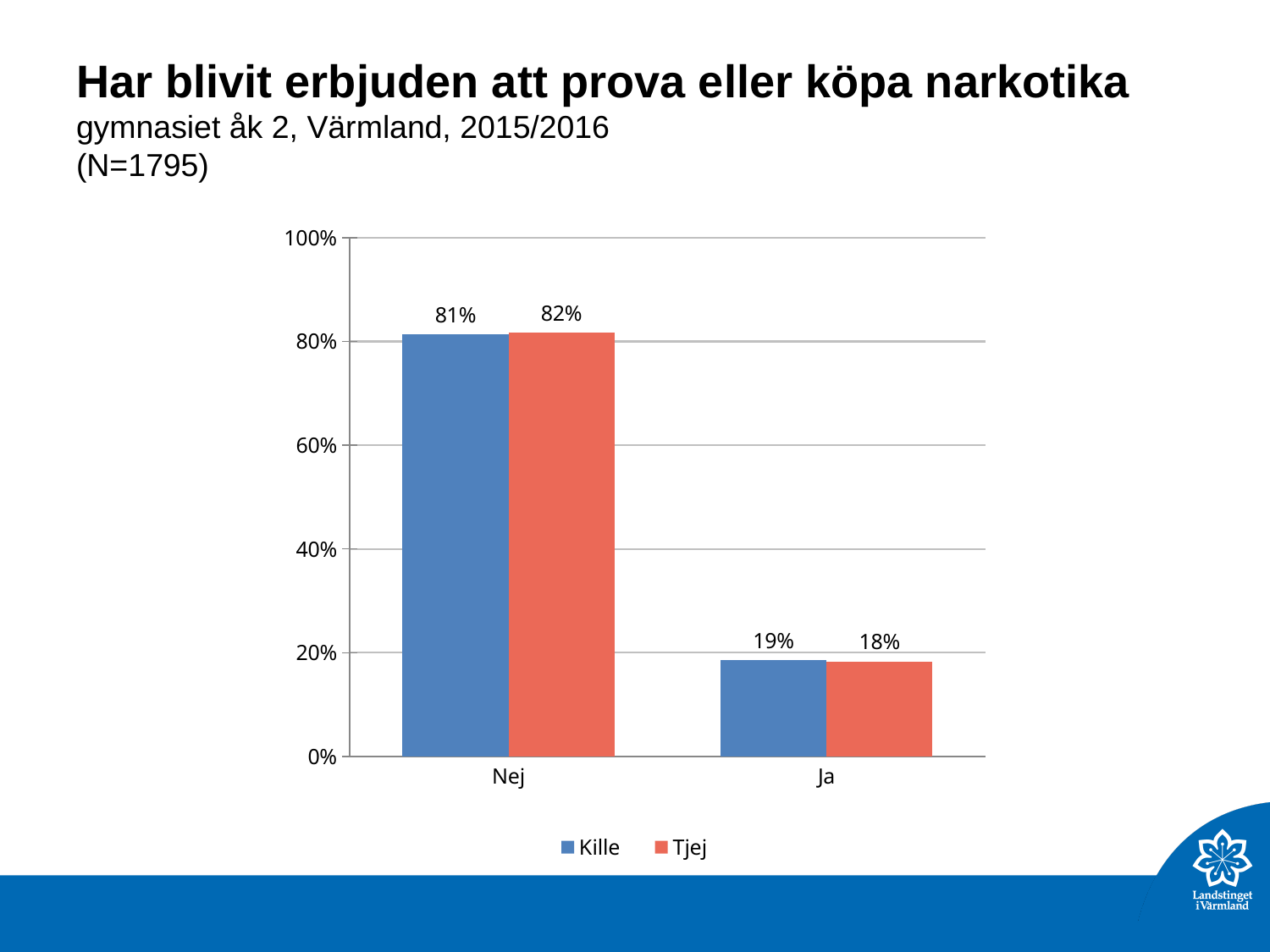
What is the value for Tjej in the Nej category? 82% Which category has the lowest value for Tjej? Ja Which category has the highest value for Kille? Nej What is the value for Kille in the Ja category? 19% How many categories are shown on the x axis? 2 What is the value for Tjej in the Ja category? 18% Is the value for Kille in the Ja category greater or less than 20%? less What kind of chart is shown on the slide? bar chart What is the value for Kille in the Nej category? 81% What is the difference between the Kille values for Nej and Ja? 62% What is the difference between the Tjej values for Nej and Ja? 64% How many series does the legend list? 2